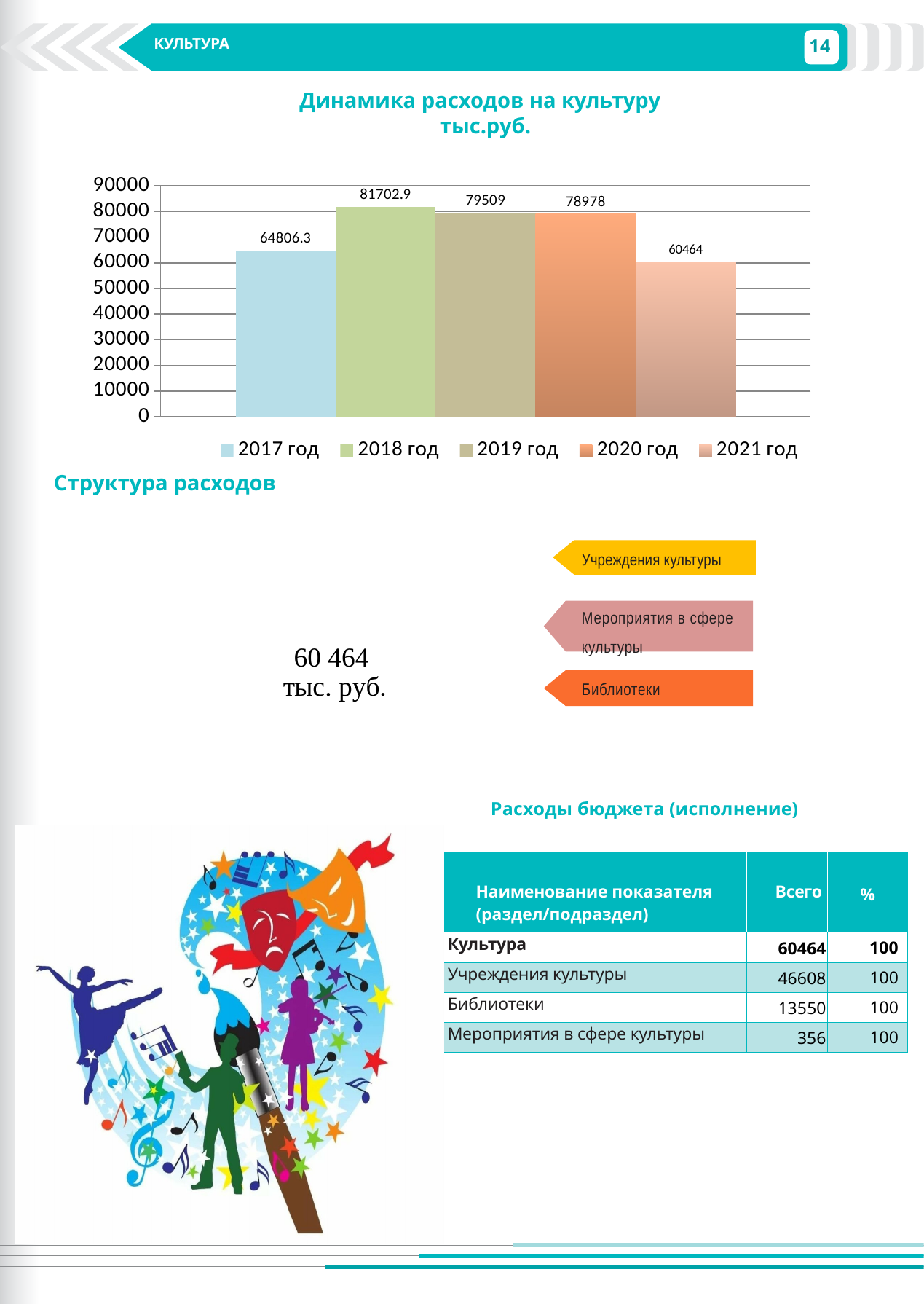
In the chart "Динамика расходов на культуру", what is the difference between the values for 2019 год and 2020 год? 531 What is the value for 2017 год in the chart "Динамика расходов на культуру"? 64806.3 Which year has the lowest value in the chart "Динамика расходов на культуру"? 2021 год In the chart "Динамика расходов на культуру", which is larger: the value for 2018 год or the value for 2021 год? 2018 год Which year has the highest value in the chart "Динамика расходов на культуру"? 2018 год How many entries does the legend of the chart "Динамика расходов на культуру" list? 5 In the chart "Динамика расходов на культуру", is the value for 2021 год greater or less than 70000? less What is the value for 2021 год in the chart "Динамика расходов на культуру"? 60464 How many bars are plotted in the chart "Динамика расходов на культуру"? 5 What is the value for 2019 год in the chart "Динамика расходов на культуру"? 79509 What kind of chart is shown under the title "Динамика расходов на культуру тыс.руб."? bar chart In the chart "Динамика расходов на культуру", what is the difference between the values for 2018 год and 2017 год? 16896.6